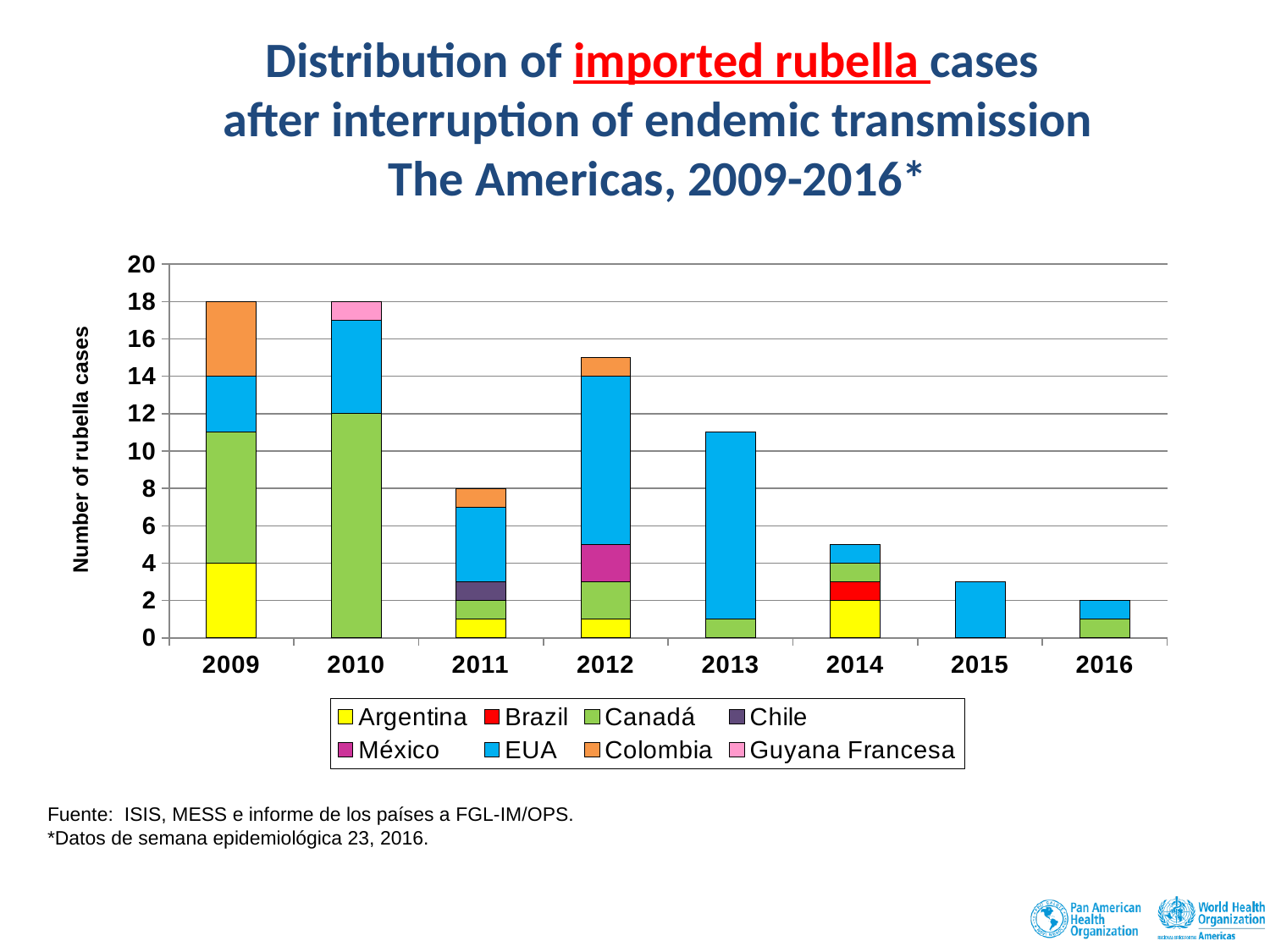
Is the total number of rubella cases in 2013 greater or less than 10? greater What is the total number of rubella cases in 2016? 2 How many years are shown on the x axis? 8 What kind of chart is shown on the slide? Stacked bar chart How many rubella cases are attributed to Argentina in 2009? 4 What is the total number of rubella cases in 2011? 8 Which year has the lowest total number of imported rubella cases? 2016 Do the total rubella cases generally rise or fall from 2012 to 2016? Fall Which year has more total rubella cases, 2013 or 2014? 2013 What is the total number of rubella cases in 2009? 18 How many series does the legend list? 8 How many rubella cases are attributed to Canadá in 2010? 12